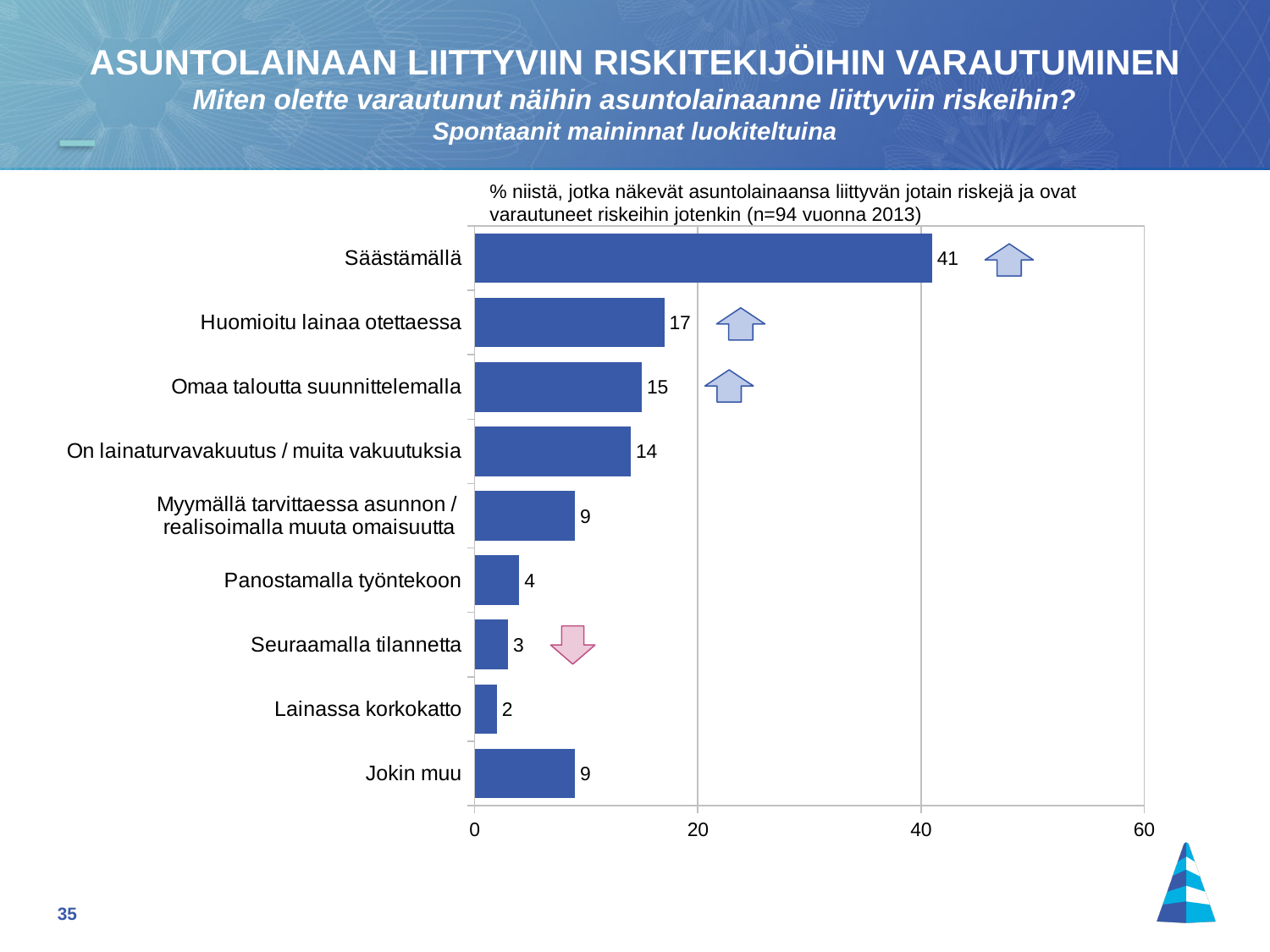
What is the value for Huomioitu lainaa otettaessa? 17 Which is larger, the value for Omaa taloutta suunnittelemalla or the value for Panostamalla työntekoon? Omaa taloutta suunnittelemalla What is the difference between the values for Säästämällä and Huomioitu lainaa otettaessa? 24 What kind of chart is shown on the slide? Bar chart What is the sample size (n) stated above the chart for 2013? n=94 Which category has the highest value? Säästämällä How many categories are shown in the chart? 9 Which category has the lowest value? Lainassa korkokatto Is the value for Säästämällä greater or less than 40? greater What is the value for Säästämällä? 41 What is the value for Lainassa korkokatto? 2 What is the value for On lainaturvavakuutus / muita vakuutuksia? 14